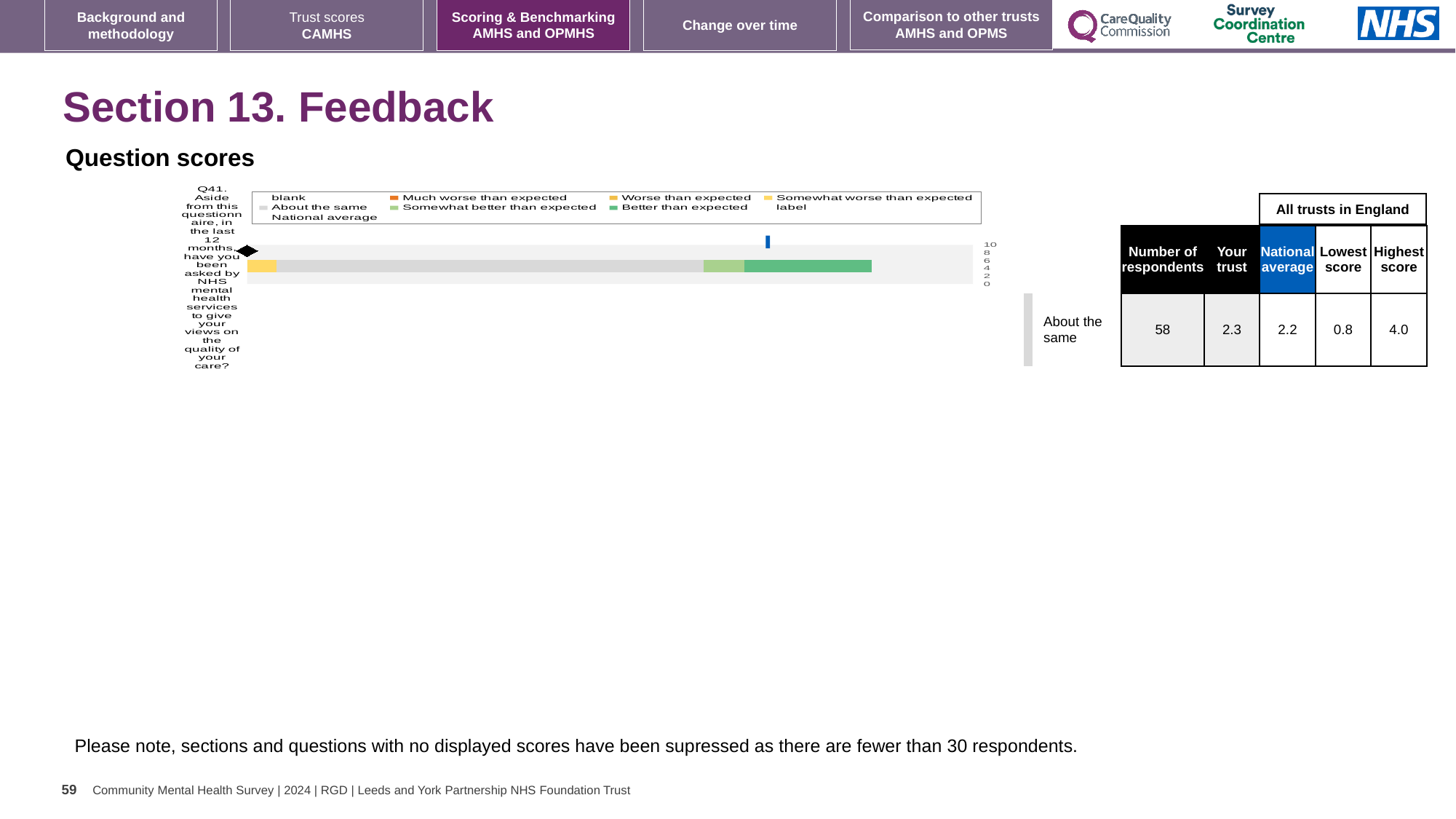
How many questions (categories) are plotted in the chart? 1 Which question number is plotted in the chart? Q41 What is the highest value shown on the chart's axis? 10 In the table next to the chart, what is the number of respondents for Q41? 58 What colour is the 'Better than expected' segment in the chart legend? green What kind of chart is shown on the slide? bar chart According to the table, what is the difference between the highest score and the lowest score for Q41? 3.2 According to the table, is the 'Your trust' score for Q41 higher or lower than the national average? higher In the table next to the chart, what is the highest score among all trusts in England for Q41? 4.0 In the table next to the chart, what is the lowest score among all trusts in England for Q41? 0.8 In the table next to the chart, what is the national average score for Q41? 2.2 In the table next to the chart, what is the 'Your trust' score for Q41? 2.3